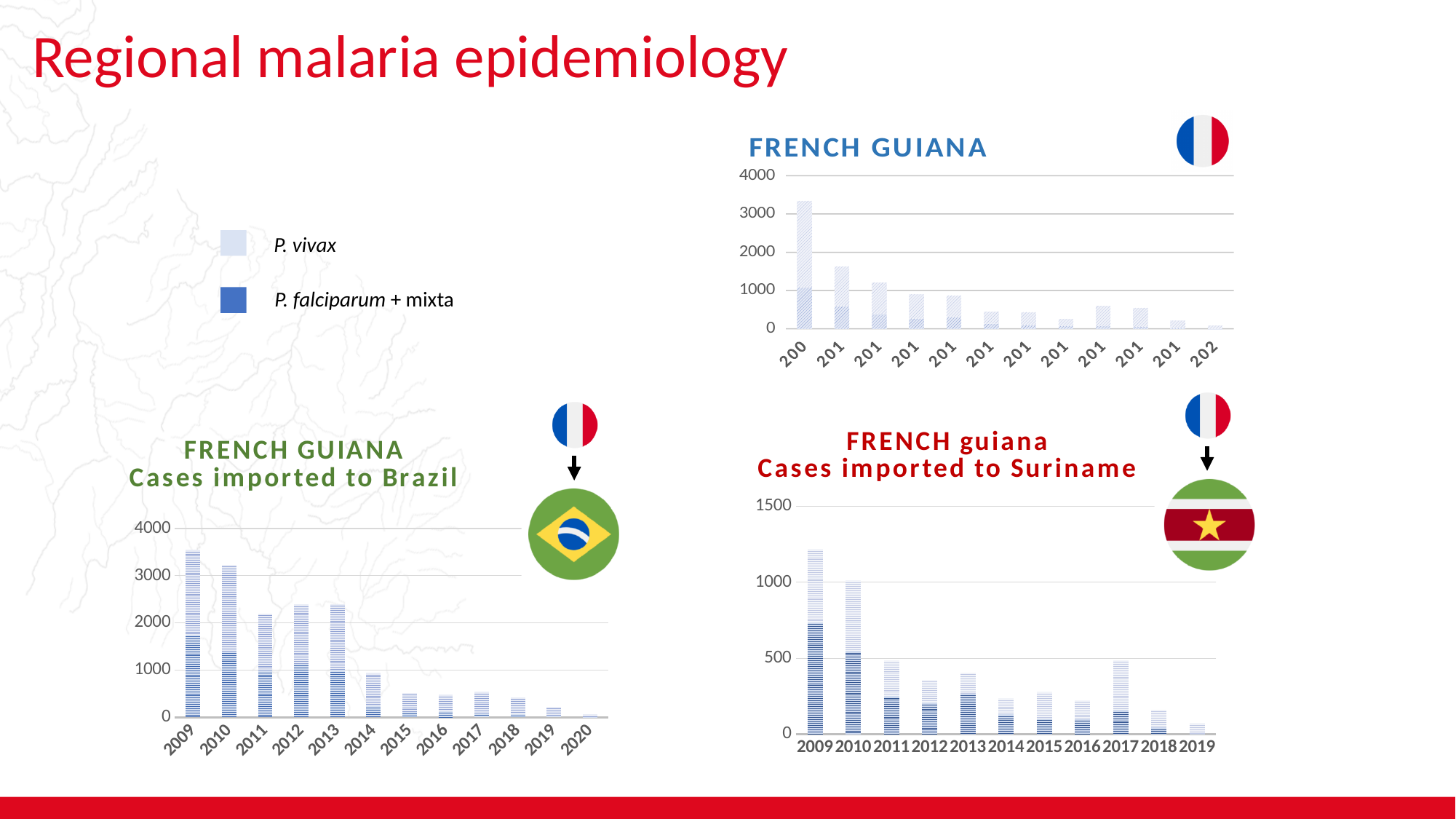
In the 'FRENCH guiana Cases imported to Suriname' chart, which year has the highest bar? 2009 In the 'FRENCH GUIANA Cases imported to Brazil' chart, which year has the lowest bar? 2020 In the 'FRENCH GUIANA Cases imported to Brazil' chart, which year has the highest bar? 2009 In the 'FRENCH guiana Cases imported to Suriname' chart, which year has the lowest bar? 2019 What kind of chart is the 'FRENCH GUIANA Cases imported to Brazil' chart? bar chart In the 'FRENCH guiana Cases imported to Suriname' chart, is the value for 2014 greater or less than 500? less In the 'FRENCH guiana Cases imported to Suriname' chart, is the value for 2009 greater or less than 1000? greater In the 'FRENCH GUIANA Cases imported to Brazil' chart, is the value for 2009 greater or less than 3000? greater How many series does the legend on the slide list? 2 In the 'FRENCH GUIANA Cases imported to Brazil' chart, which is larger, the value for 2009 or the value for 2010? 2009 How many years are shown on the x axis of the 'FRENCH GUIANA Cases imported to Brazil' chart? 12